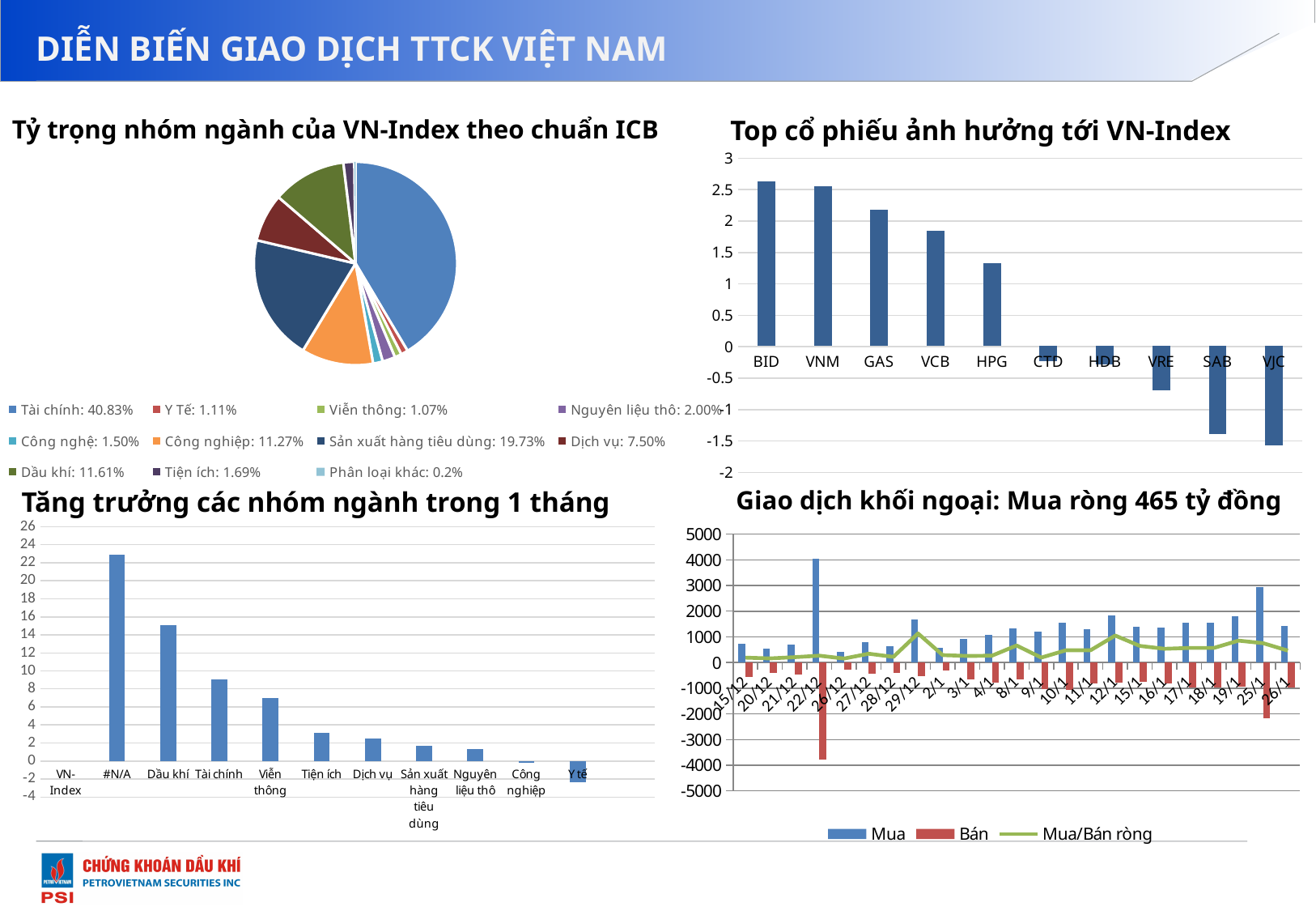
In the chart 'Top cổ phiếu ảnh hưởng tới VN-Index', is the value for HPG greater or less than 1? greater In the pie chart 'Tỷ trọng nhóm ngành của VN-Index theo chuẩn ICB', what share does Sản xuất hàng tiêu dùng have? 19.73% In the pie chart 'Tỷ trọng nhóm ngành của VN-Index theo chuẩn ICB', how many sectors are listed in the legend? 11 In the chart 'Tăng trưởng các nhóm ngành trong 1 tháng', is the value for Dầu khí greater or less than 14? greater In the chart 'Top cổ phiếu ảnh hưởng tới VN-Index', which stock has the highest value? BID In the pie chart 'Tỷ trọng nhóm ngành của VN-Index theo chuẩn ICB', what share does Tài chính have? 40.83% In the pie chart 'Tỷ trọng nhóm ngành của VN-Index theo chuẩn ICB', which sector has the largest share? Tài chính In the chart 'Top cổ phiếu ảnh hưởng tới VN-Index', which stock has the lowest value? VJC In the chart 'Tăng trưởng các nhóm ngành trong 1 tháng', which category has the highest value? #N/A In the chart 'Top cổ phiếu ảnh hưởng tới VN-Index', how many stocks are shown? 10 In the chart 'Giao dịch khối ngoại: Mua ròng 465 tỷ đồng', how many series does the legend list? 3 In the pie chart 'Tỷ trọng nhóm ngành của VN-Index theo chuẩn ICB', which is larger, Dầu khí or Công nghiệp? Dầu khí